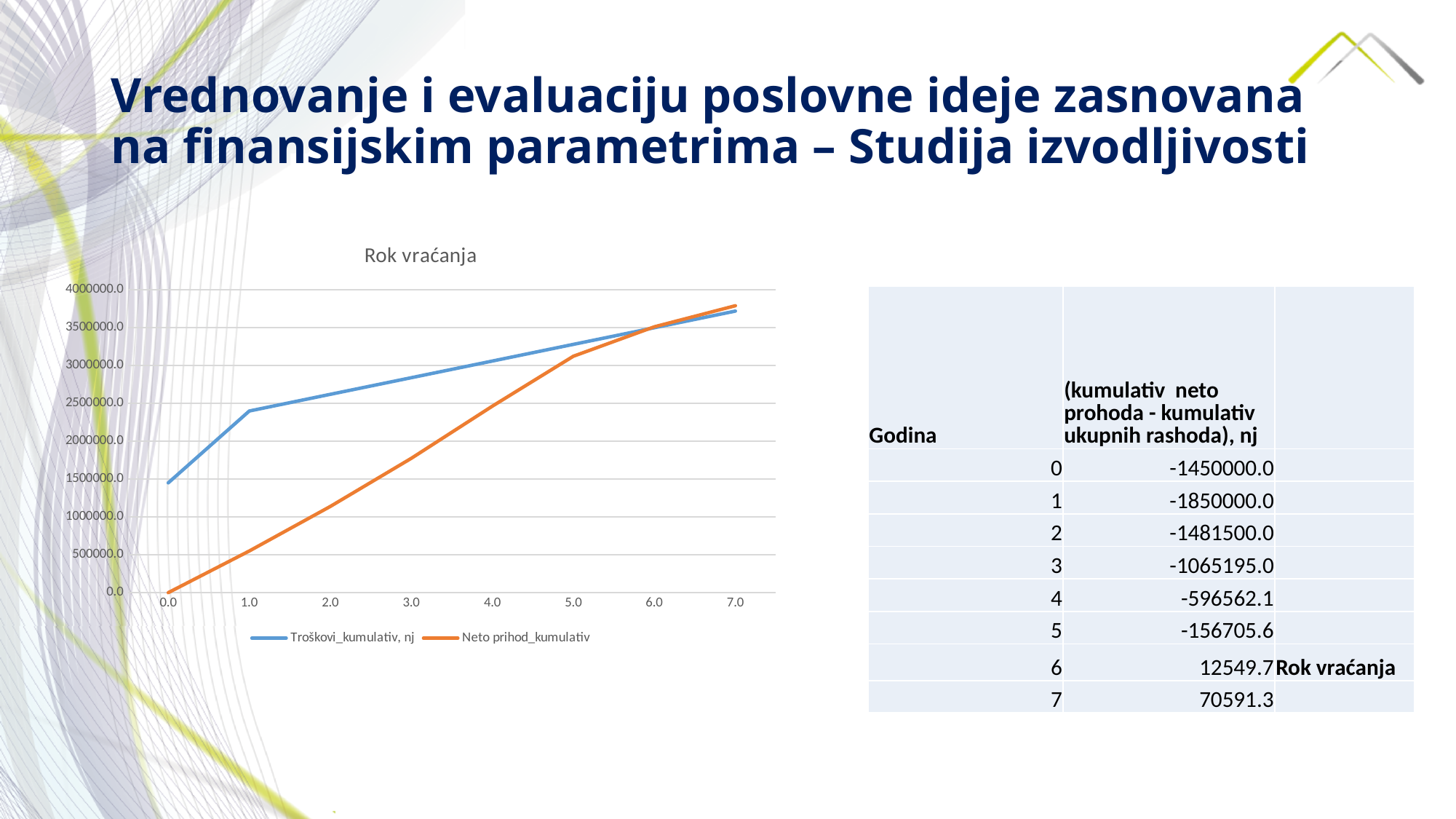
Is the value for Neto prihod_kumulativ at 2.0 greater or less than 1500000.0? less How many series does the chart's legend list? 2 Is the value for Troškovi_kumulativ, nj at 1.0 greater or less than 2000000.0? greater At 1.0 on the x axis, which series has the higher value, Troškovi_kumulativ, nj or Neto prihod_kumulativ? Troškovi_kumulativ, nj How many points are plotted along the x axis for each series in the chart? 8 What is the title of the chart? Rok vraćanja What kind of chart is shown on the slide? line chart Is the value for Troškovi_kumulativ, nj at 7.0 greater or less than 3500000.0? greater What is the value of Neto prihod_kumulativ at 0.0 on the x axis? 0.0 Does the Neto prihod_kumulativ line rise or fall as the x axis goes from 0.0 to 7.0? rise What colour is the Troškovi_kumulativ, nj line in the chart? blue